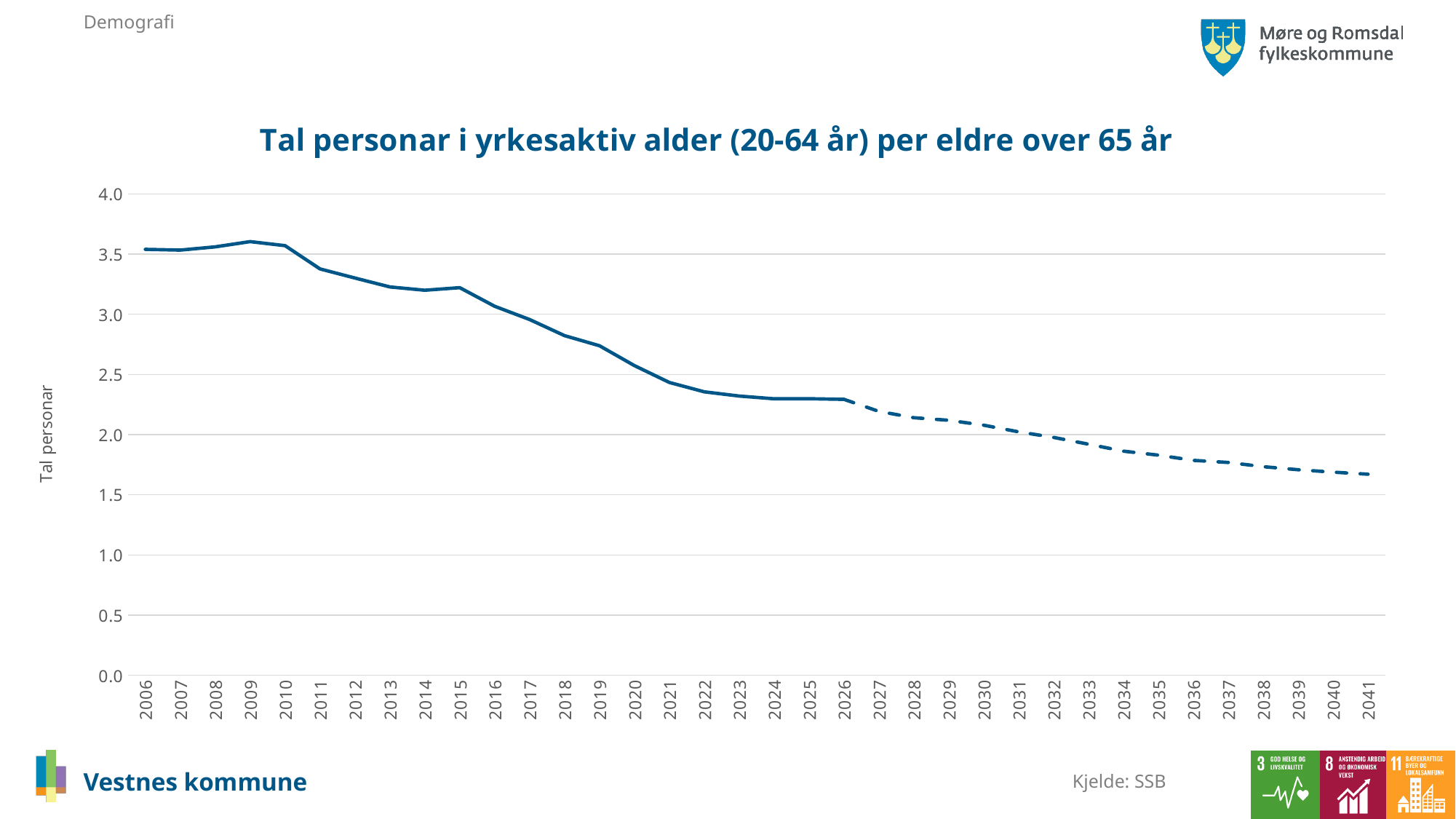
Which year has the highest value in the chart? 2009 Is the value for 2015 greater or less than 3.0? greater Which year has the larger value, 2015 or 2020? 2015 Do the values generally rise or fall from 2010 to 2041? fall Is the value for 2021 greater or less than 2.5? less Which year has the lowest value in the chart? 2041 Is the value for 2036 greater or less than 2.0? less What is the label on the vertical axis of the chart? Tal personar How many years are shown along the x axis of the chart? 36 What is the title of the chart? Tal personar i yrkesaktiv alder (20-64 år) per eldre over 65 år What kind of chart is shown on the slide? line chart